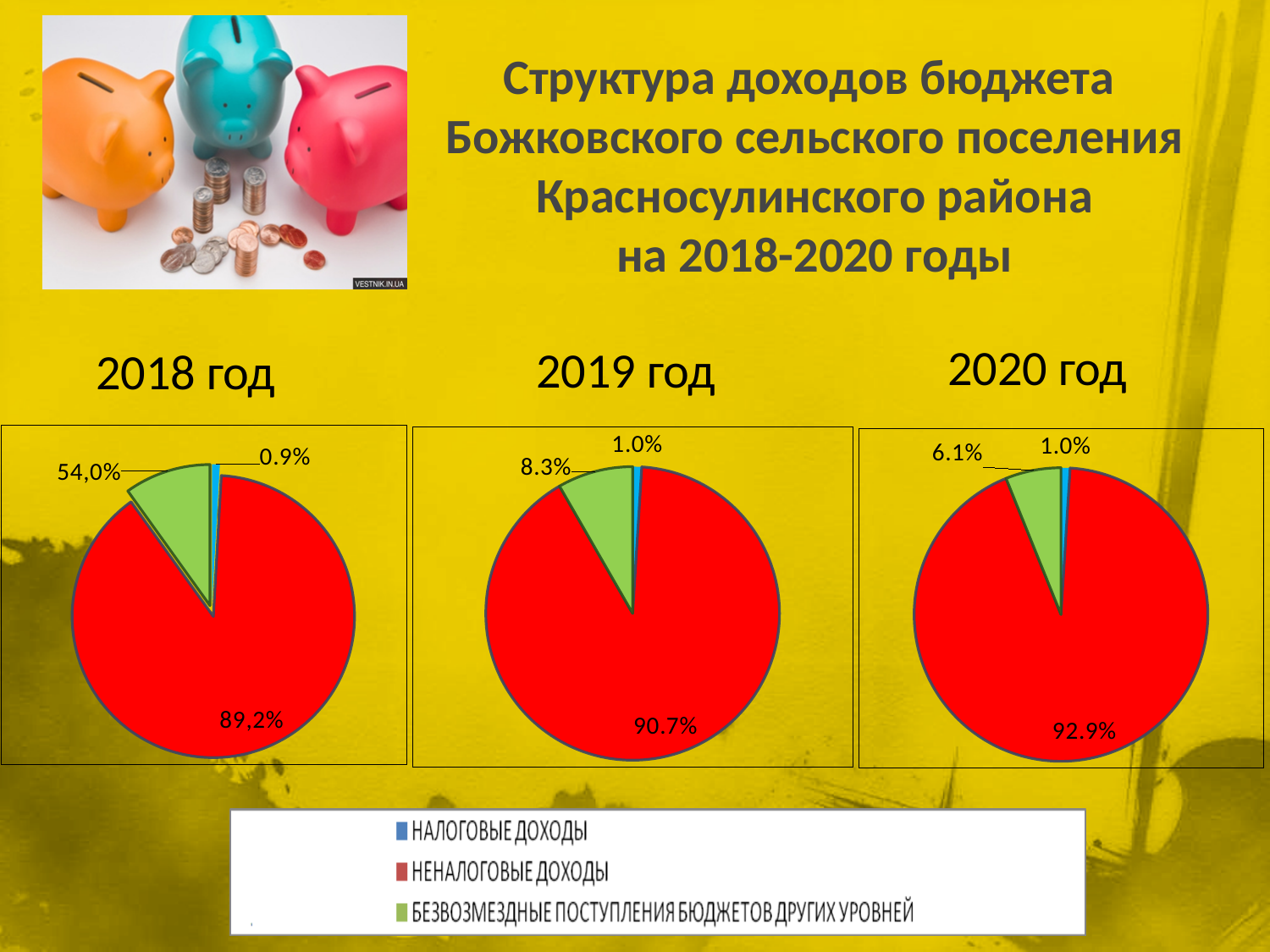
What type of charts are shown on the slide? pie charts In the 2018 год pie chart, what share is labelled for the blue slice (НАЛОГОВЫЕ ДОХОДЫ)? 0.9% In the 2018 год pie chart, what share is labelled for the red slice (НЕНАЛОГОВЫЕ ДОХОДЫ)? 89,2% In the 2019 год pie chart, which category has the smallest slice? НАЛОГОВЫЕ ДОХОДЫ In the 2019 год pie chart, what share is labelled for the red slice (НЕНАЛОГОВЫЕ ДОХОДЫ)? 90.7% How many categories does the legend list? 3 How many pie charts are on the slide? 3 Comparing the 2019 год and 2020 год pie charts, which year has the larger share for НЕНАЛОГОВЫЕ ДОХОДЫ? 2020 год In the 2020 год pie chart, what share is labelled for the green slice (БЕЗВОЗМЕЗДНЫЕ ПОСТУПЛЕНИЯ БЮДЖЕТОВ ДРУГИХ УРОВНЕЙ)? 6.1% Across the 2018, 2019 and 2020 pie charts, does the labelled share of the red slice (НЕНАЛОГОВЫЕ ДОХОДЫ) rise or fall over the years? rise In the 2020 год pie chart, which category has the largest slice? НЕНАЛОГОВЫЕ ДОХОДЫ In the 2019 год pie chart, what is the difference between the red slice (90.7%) and the green slice (8.3%)? 82.4%